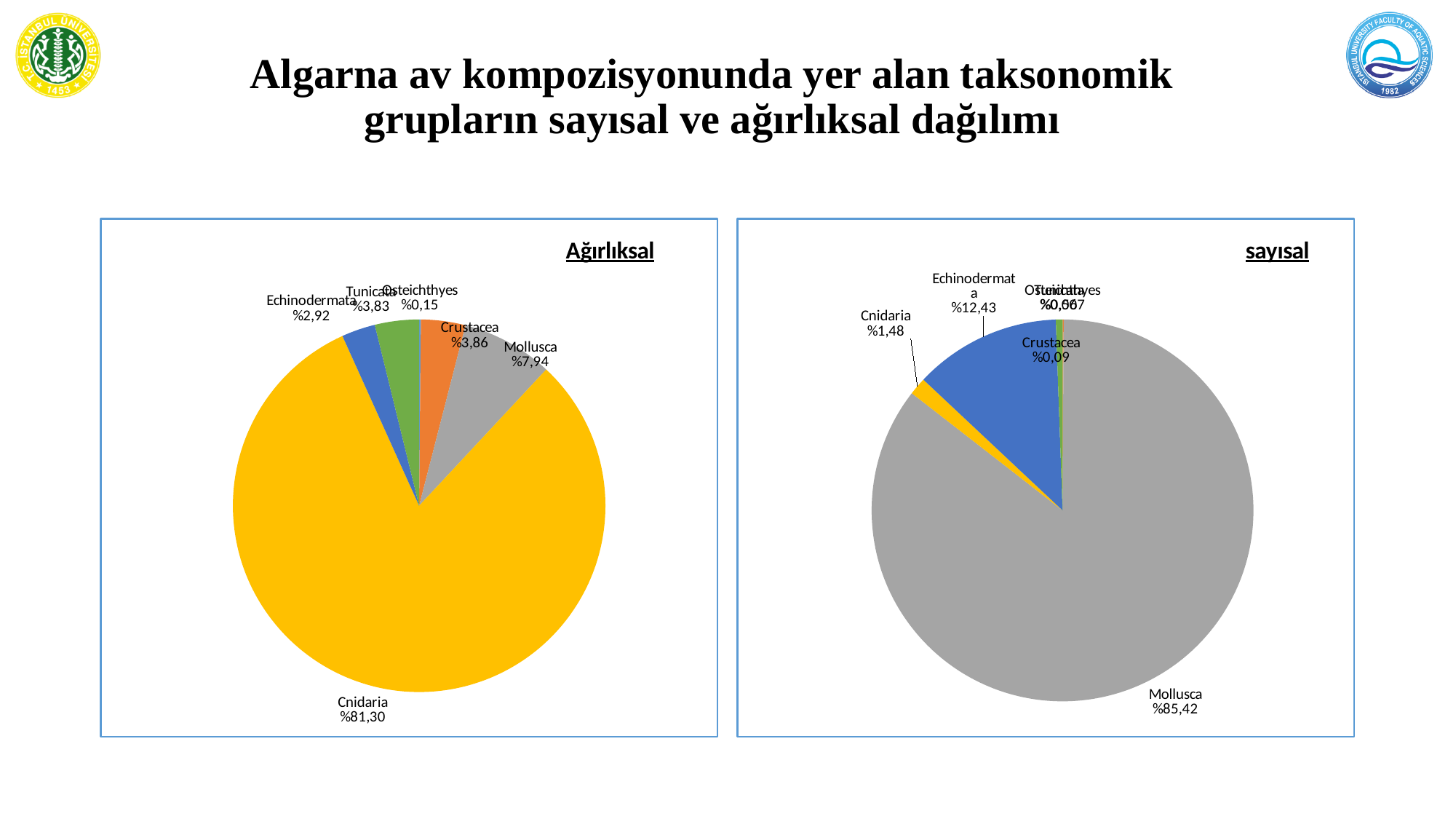
What is the title of the chart on the right side of the slide? sayısal In the sayısal pie chart, which is larger, the share of Echinodermata or the share of Cnidaria? Echinodermata In the Ağırlıksal pie chart, which group has the largest share? Cnidaria In the sayısal pie chart, what share does Echinodermata have? %12,43 In the sayısal pie chart, what share does Cnidaria have? %1,48 In the Ağırlıksal pie chart, which group has the smallest share? Osteichthyes In the Ağırlıksal pie chart, what share does Mollusca have? %7,94 What type of chart is used on the slide? Pie chart In the Ağırlıksal pie chart, what share does Cnidaria have? %81,30 In the sayısal pie chart, what share does Mollusca have? %85,42 In the Ağırlıksal pie chart, what is the difference between the shares of Mollusca and Crustacea? %4,08 In the Ağırlıksal pie chart, how many groups are shown? 6